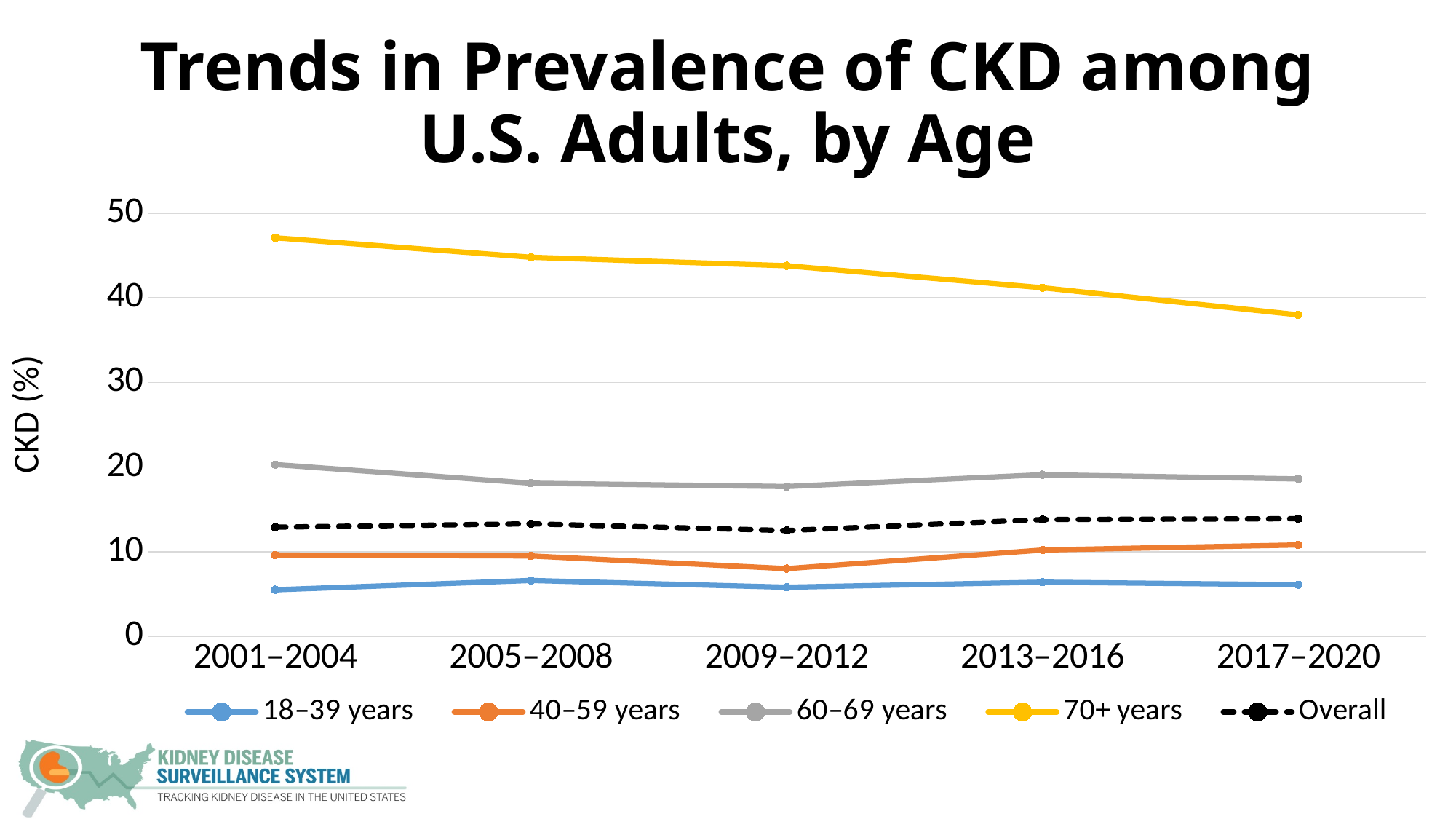
Is the Overall value in 2001–2004 greater or less than 10? greater Is the value for 70+ years in 2001–2004 greater or less than 40? greater Does the CKD prevalence for the 70+ years group rise or fall from 2001–2004 to 2017–2020? fall Is the value for 70+ years in 2017–2020 greater or less than 40? less In 2017–2020, which is larger: the value for 40–59 years or the value for 18–39 years? 40–59 years Which age group has the lowest CKD prevalence in 2001–2004? 18–39 years Which series is drawn with a dashed line? Overall Which age group has the highest CKD prevalence in 2017–2020? 70+ years How many series does the legend list? 5 How many time periods are shown on the x axis? 5 What kind of chart is shown on the slide? line chart